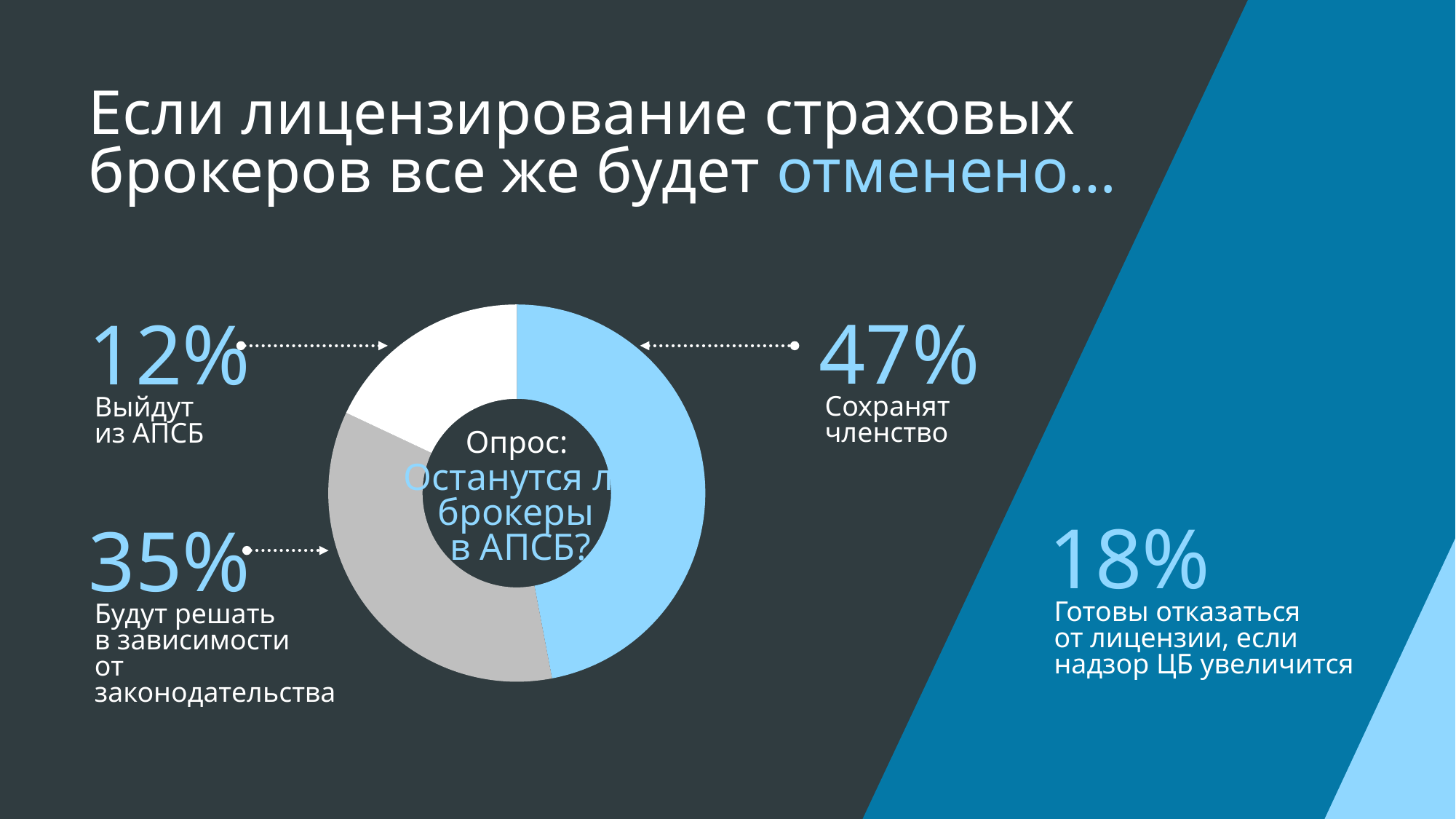
What share of respondents will keep their membership (Сохранят членство)? 47% What share of respondents will leave the APSB (Выйдут из АПСБ)? 12% What is the difference in percentage points between 'Сохранят членство' and 'Будут решать в зависимости от законодательства'? 12 What share of respondents will decide depending on legislation (Будут решать в зависимости от законодательства)? 35% What question is written in the centre of the donut chart? Опрос: Останутся ли брокеры в АПСБ? Which response has the smallest share in the donut chart? Выйдут из АПСБ Which is larger: the share for 'Будут решать в зависимости от законодательства' or the share for 'Выйдут из АПСБ'? Будут решать в зависимости от законодательства What type of chart is shown on the slide? Donut (pie) chart Which response has the largest share in the donut chart? Сохранят членство How many segments does the donut chart have? 3 What is the difference in percentage points between 'Сохранят членство' and 'Выйдут из АПСБ'? 35 What colour is the segment for 'Сохранят членство'? Light blue